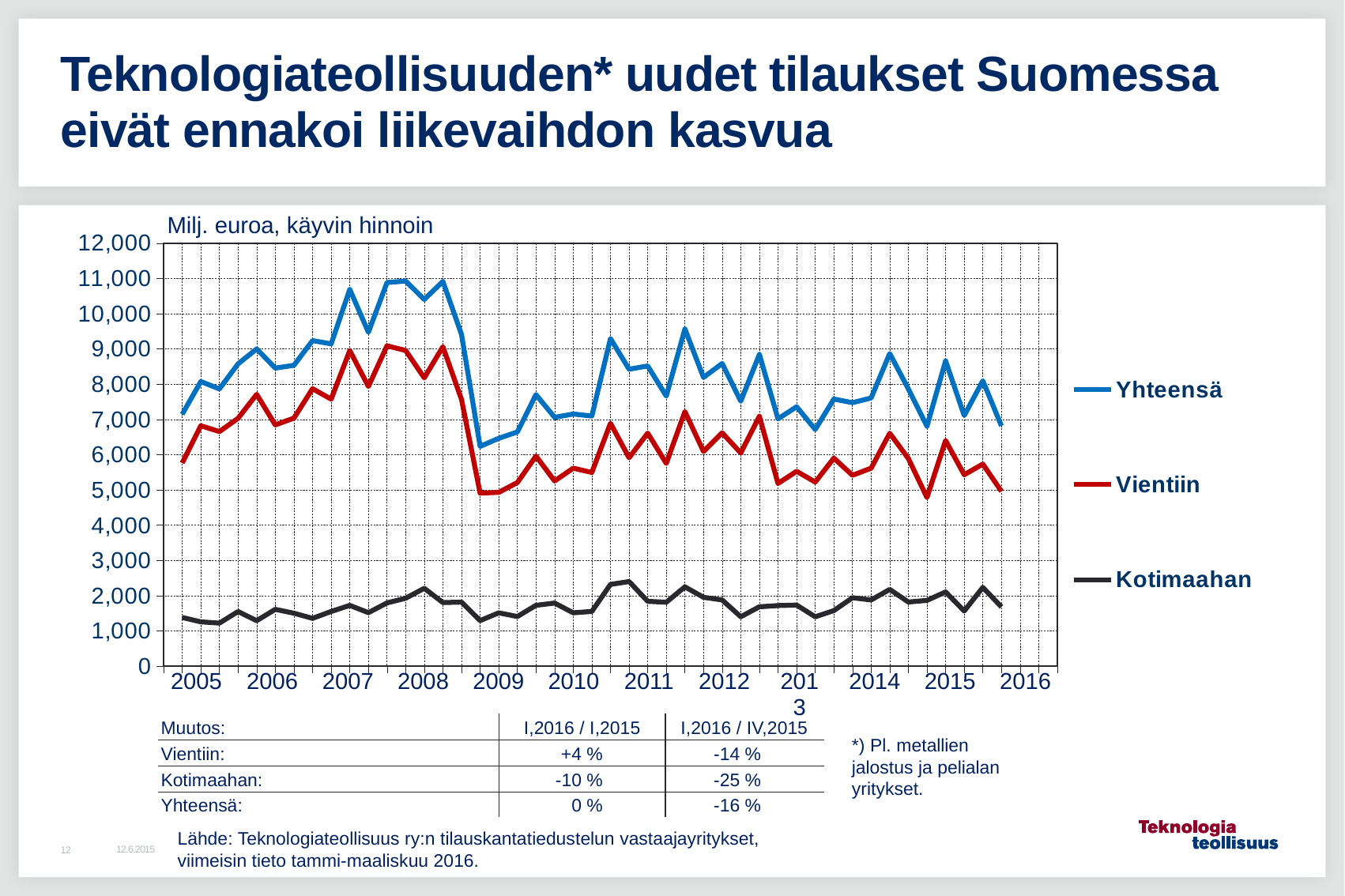
Is the peak value of Yhteensä around 2008 greater or less than 10,000? greater Which series is larger in 2012, Vientiin or Kotimaahan? Vientiin Which series is plotted with the blue line? Yhteensä What kind of chart is shown on the slide? line chart Which series has the lowest values throughout the chart? Kotimaahan Is the lowest value of Yhteensä in 2009 greater or less than 7,000? less How many series does the chart legend list? 3 What unit is given above the chart's vertical axis? Milj. euroa, käyvin hinnoin Which series has the highest values throughout the chart? Yhteensä How many year labels are shown on the x axis? 12 Does the Yhteensä line rise or fall between 2008 and 2009? fall Is the value of Kotimaahan at any point greater or less than 3,000? less